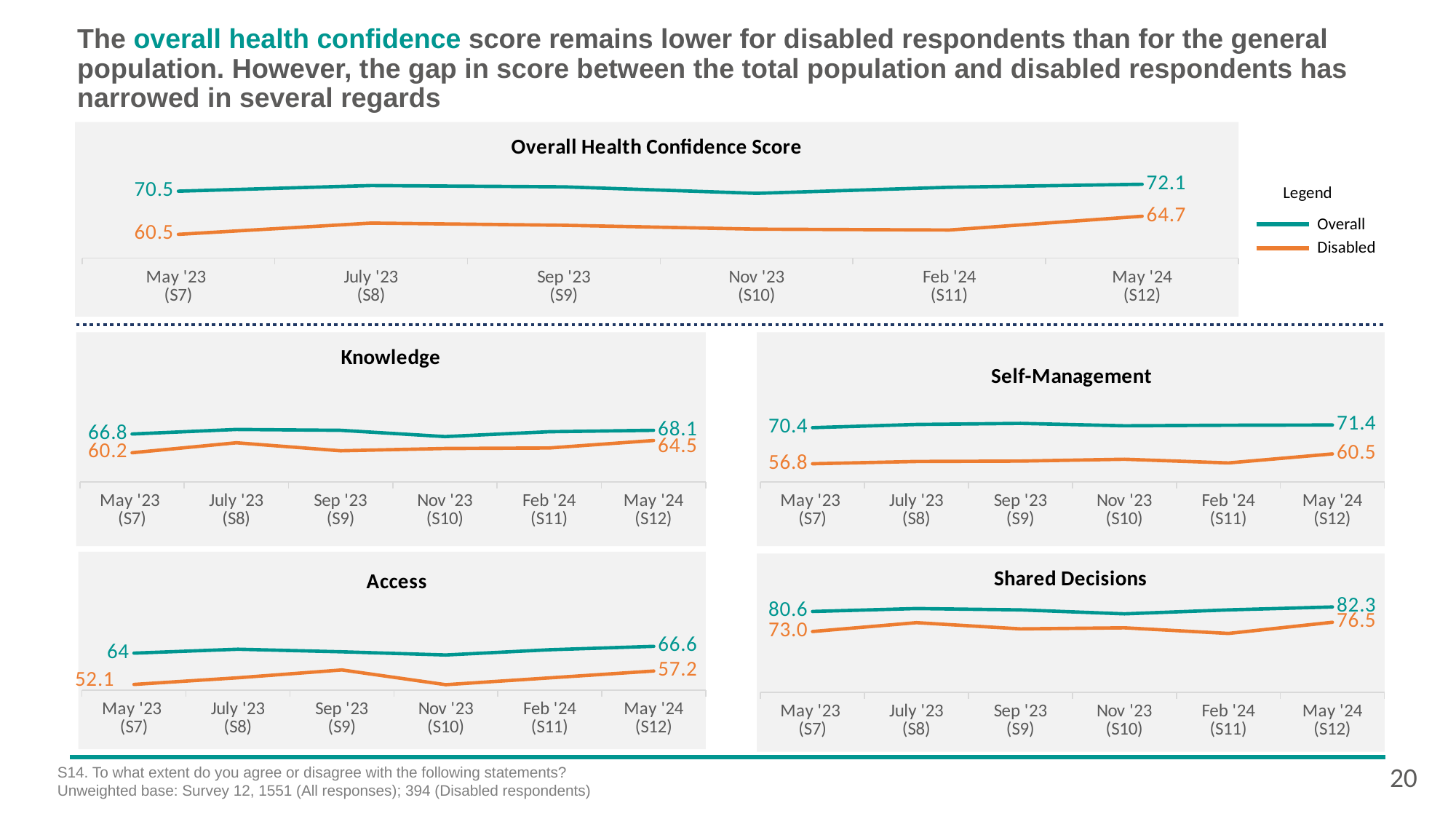
In the Shared Decisions chart, what is the Disabled score at May '24 (S12)? 76.5 How many survey waves are plotted along the x axis of the Overall Health Confidence Score chart? 6 What kind of chart is the Self-Management chart? Line chart In the Access chart, by how much did the Disabled score change from May '23 (S7) to May '24 (S12)? 5.1 In the Self-Management chart, what is the Disabled score at May '23 (S7)? 56.8 In the Overall Health Confidence Score chart, what is the Overall score at May '24 (S12)? 72.1 In the Overall Health Confidence Score chart, what is the difference between the Overall and Disabled scores at May '24 (S12)? 7.4 In the Knowledge chart, what is the Disabled score at May '24 (S12)? 64.5 In the Access chart, what is the Overall score at May '23 (S7)? 64 How many series does the legend list? 2 In the Shared Decisions chart, which series has the higher score at May '24 (S12), Overall or Disabled? Overall In the Overall Health Confidence Score chart, what is the Disabled score at May '23 (S7)? 60.5